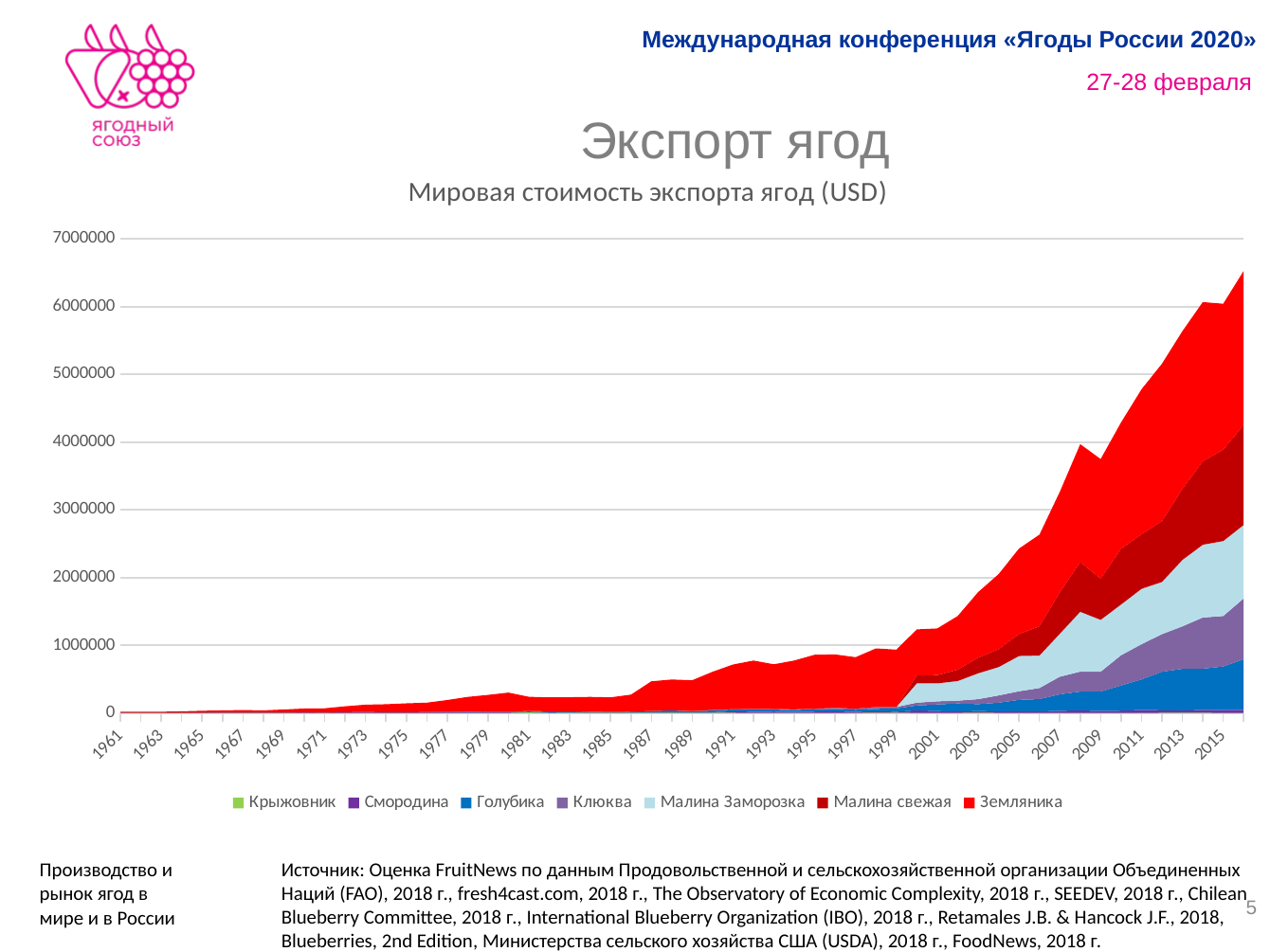
What colour represents Голубика in the legend? Blue Is the total export value in 2005 greater or less than 2000000? greater Which series accounts for the largest share of the total at the right end of the chart? Земляника Which is larger at the right end of the chart, the value for Земляника or the value for Крыжовник? Земляника Is the total export value in 2011 greater or less than 4000000? greater What is the title of the chart? Мировая стоимость экспорта ягод (USD) What kind of chart is shown on the slide? Stacked area chart Is the total export value at the last point on the chart greater or less than 6000000? greater How many series does the legend list? 7 What is the first year labelled on the x axis? 1961 Does the total world berry export value rise or fall from 1961 to the end of the chart? Rises